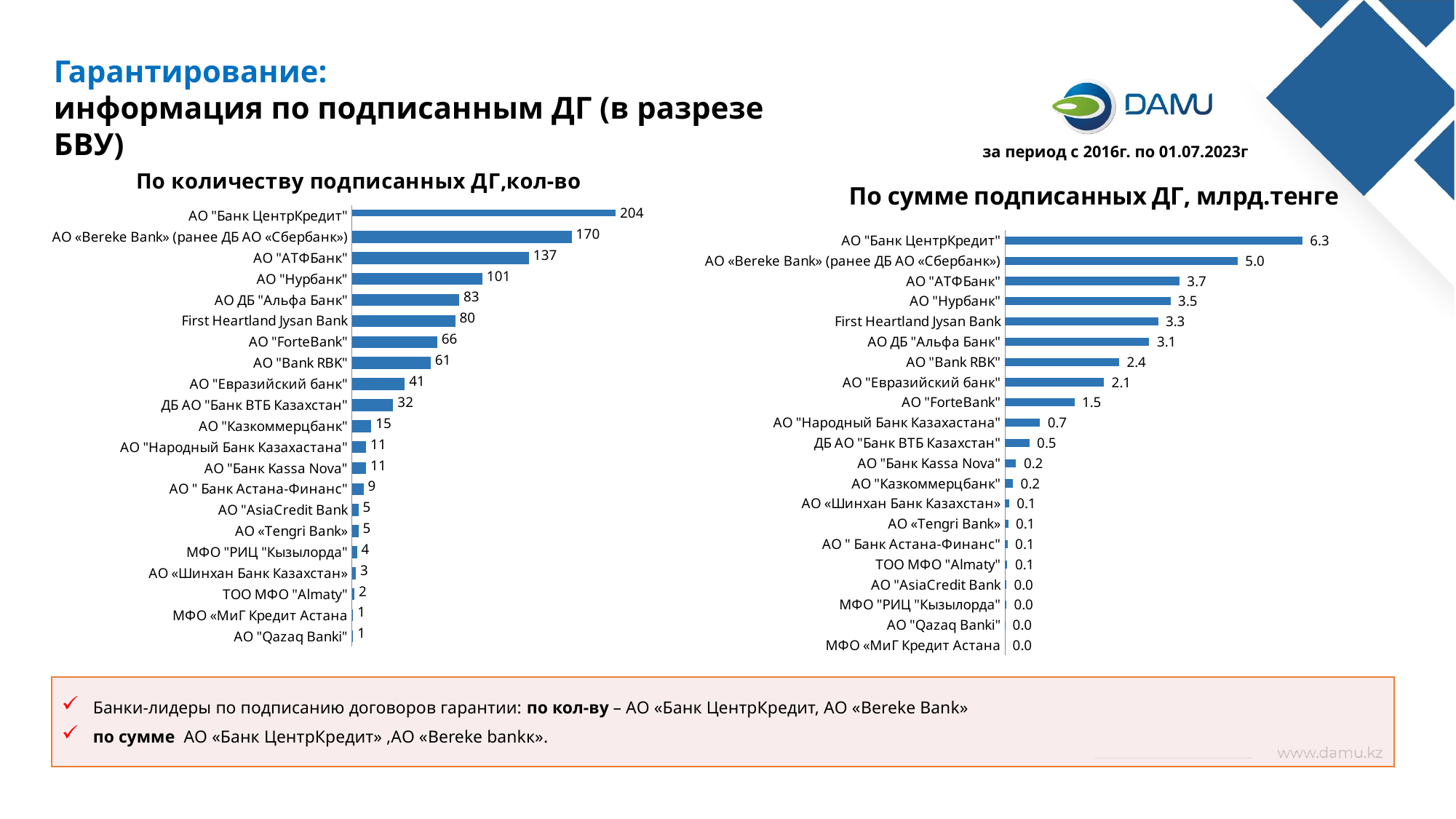
On the chart "По сумме подписанных ДГ, млрд.тенге", what is the value for АО "Народный Банк Казахастана"? 0.7 On the chart "По количеству подписанных ДГ,кол-во", what is the value for АО "ForteBank"? 66 What type of chart is used for "По сумме подписанных ДГ, млрд.тенге"? Bar chart On the chart "По сумме подписанных ДГ, млрд.тенге", what is the difference between АО "Банк ЦентрКредит" and АО "Нурбанк"? 2.8 On the chart "По количеству подписанных ДГ,кол-во", which is larger: АО "Нурбанк" or АО ДБ "Альфа Банк"? АО "Нурбанк" On the chart "По количеству подписанных ДГ,кол-во", what is the difference between АО "Банк ЦентрКредит" and АО «Bereke Bank» (ранее ДБ АО «Сбербанк»)? 34 On the chart "По сумме подписанных ДГ, млрд.тенге", which bank has the highest sum of signed agreements? АО "Банк ЦентрКредит" On the chart "По количеству подписанных ДГ,кол-во", which bank has the highest number of signed agreements? АО "Банк ЦентрКредит" On the chart "По сумме подписанных ДГ, млрд.тенге", which is larger: First Heartland Jysan Bank or АО "Bank RBK"? First Heartland Jysan Bank On the chart "По количеству подписанных ДГ,кол-во", how many signed guarantee agreements does АО "Банк ЦентрКредит" have? 204 On the chart "По сумме подписанных ДГ, млрд.тенге", what is the value for АО "АТФБанк"? 3.7 On the chart "По количеству подписанных ДГ,кол-во", how many banks are listed? 21